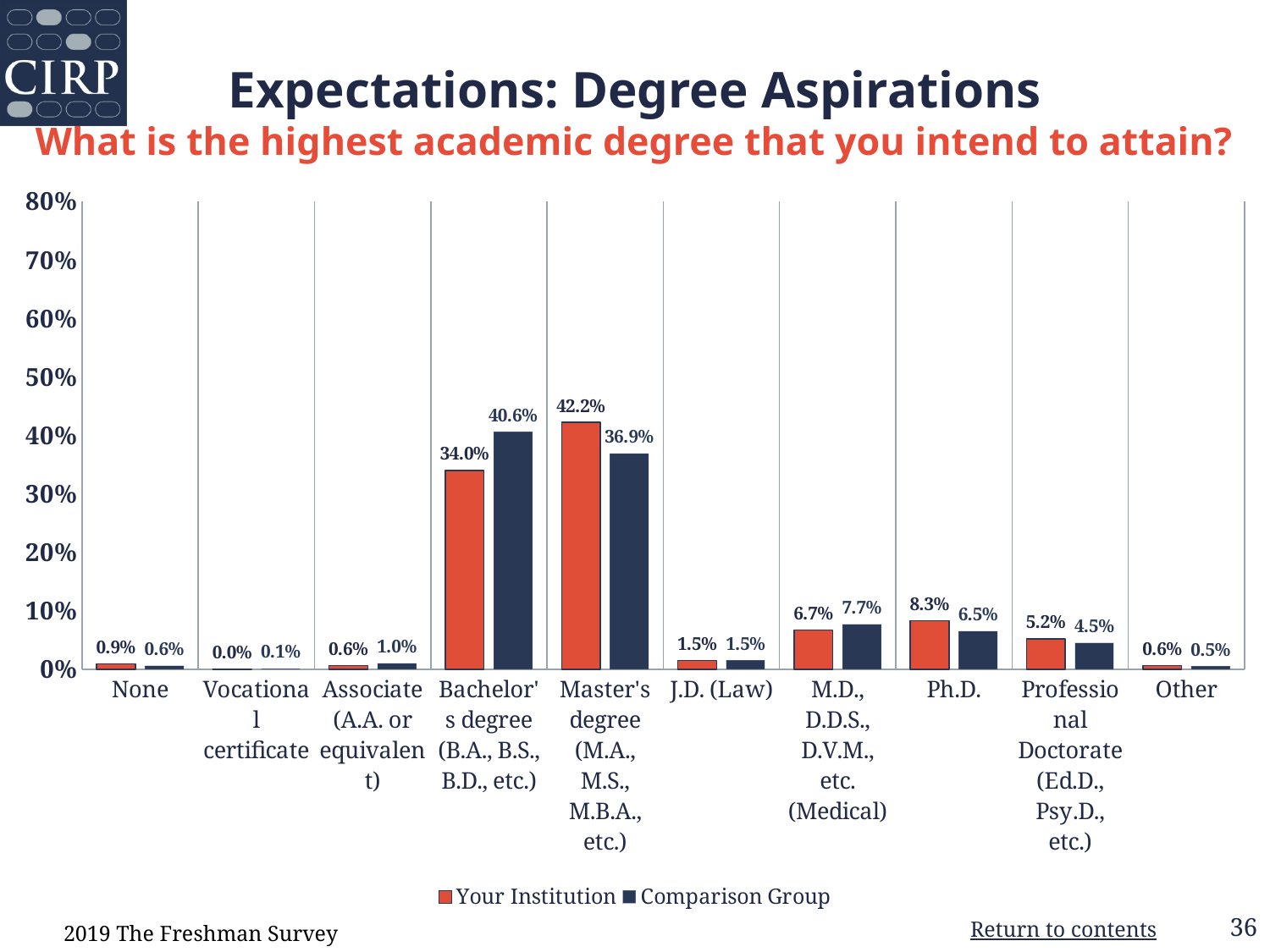
What is the value for Comparison Group for M.D., D.D.S., D.V.M., etc. (Medical)? 7.7% Which is larger for Ph.D.: Your Institution or Comparison Group? Your Institution What is the value for Comparison Group for Professional Doctorate (Ed.D., Psy.D., etc.)? 4.5% Which category has the lowest value for Your Institution? Vocational certificate What kind of chart is shown on the slide? Bar chart Which category has the highest value for Your Institution? Master's degree What is the value for Comparison Group for Bachelor's degree? 40.6% How many categories are shown on the x axis? 10 What is the value for Your Institution for Ph.D.? 8.3% What is the difference between Your Institution and Comparison Group for Bachelor's degree? 6.6% What is the value for Your Institution for Master's degree? 42.2% How many series does the legend list? 2